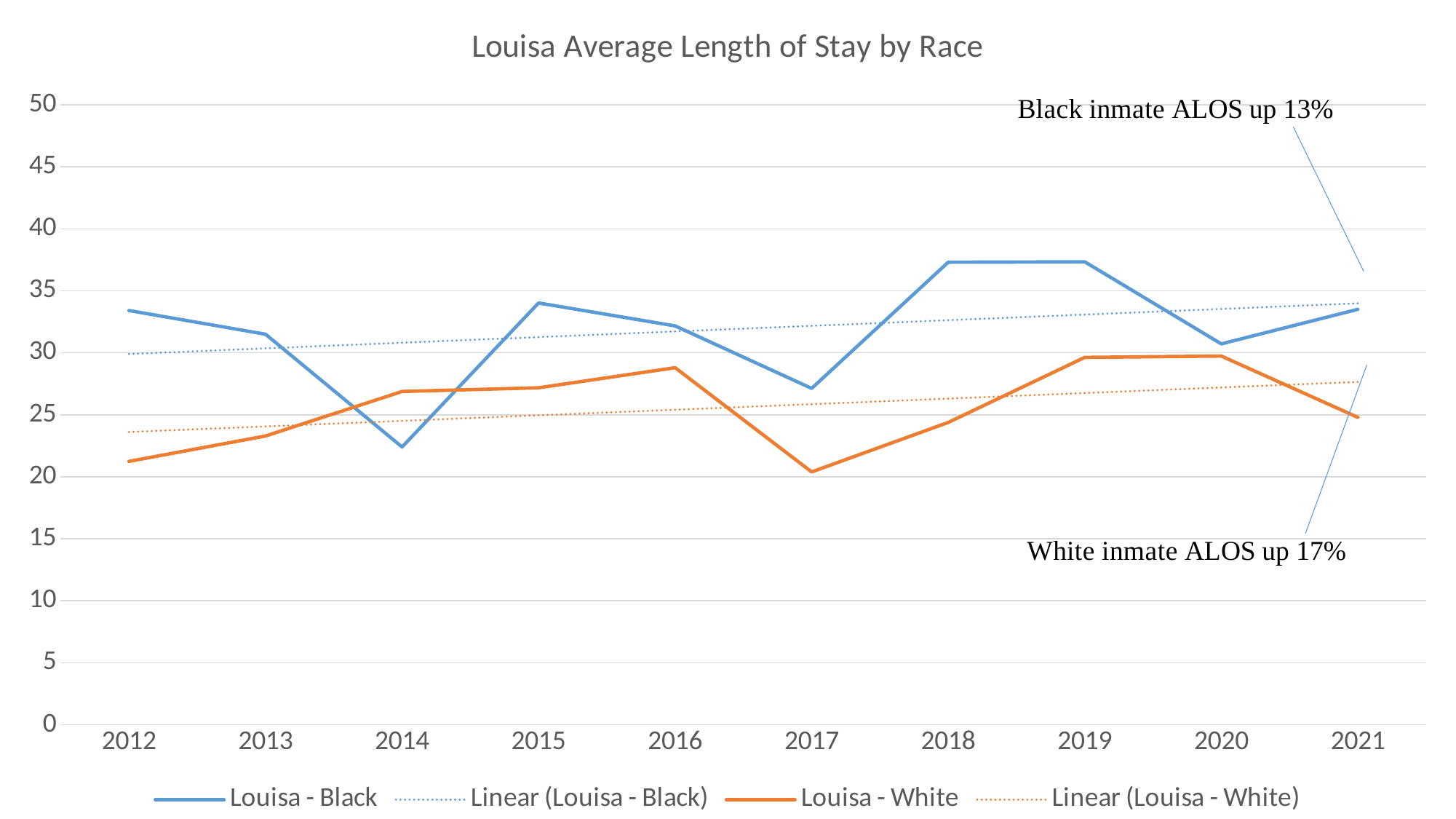
Is the Louisa - Black value for 2014 greater or less than 25? less Is the Louisa - White value for 2017 greater or less than 25? less How many years are shown on the x axis? 10 In which year is the Louisa - Black value lowest? 2014 Does the Linear (Louisa - White) trend line rise or fall from 2012 to 2021? rise What is the title of the chart? Louisa Average Length of Stay by Race In 2014, which series has the larger value, Louisa - Black or Louisa - White? Louisa - White Is the Louisa - Black value for 2018 greater or less than 35? greater What kind of chart is shown on the slide? line chart How many series does the legend list? 4 In 2012, which series has the larger value, Louisa - Black or Louisa - White? Louisa - Black